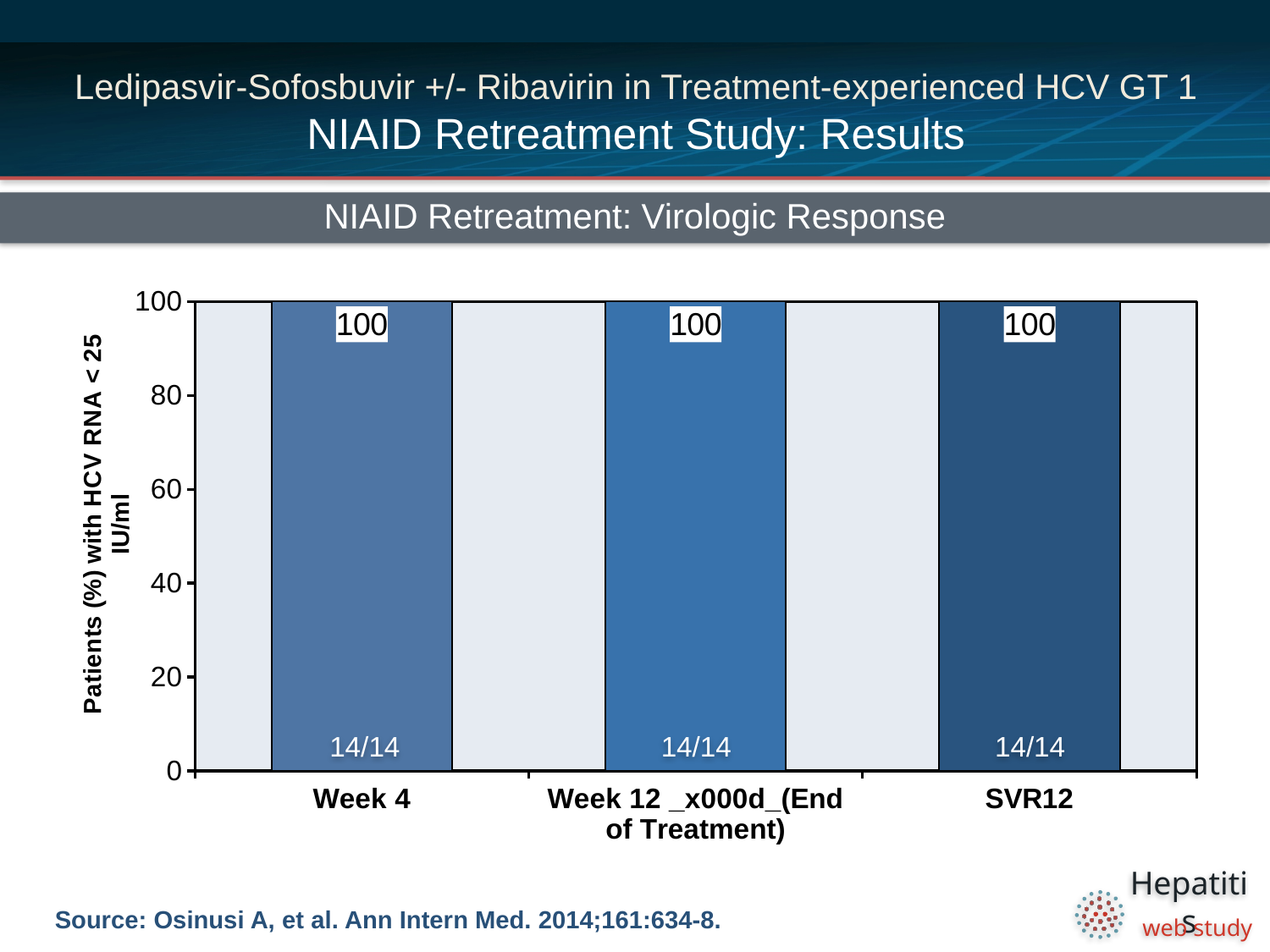
What fraction of patients is shown inside the SVR12 bar? 14/14 What is the difference between the values for Week 4 and SVR12? 0 What is the value for Week 4? 100 What is the value for SVR12? 100 Do the values rise, fall, or stay the same from Week 4 to SVR12? stay the same What fraction of patients is shown inside the Week 4 bar? 14/14 How many categories are shown on the x axis? 3 What is the title of the chart? NIAID Retreatment: Virologic Response What is the y-axis label of the chart? Patients (%) with HCV RNA < 25 IU/ml What kind of chart is shown on the slide? bar chart Is the value for Week 4 greater or less than 80? greater What is the value for Week 12 (End of Treatment)? 100